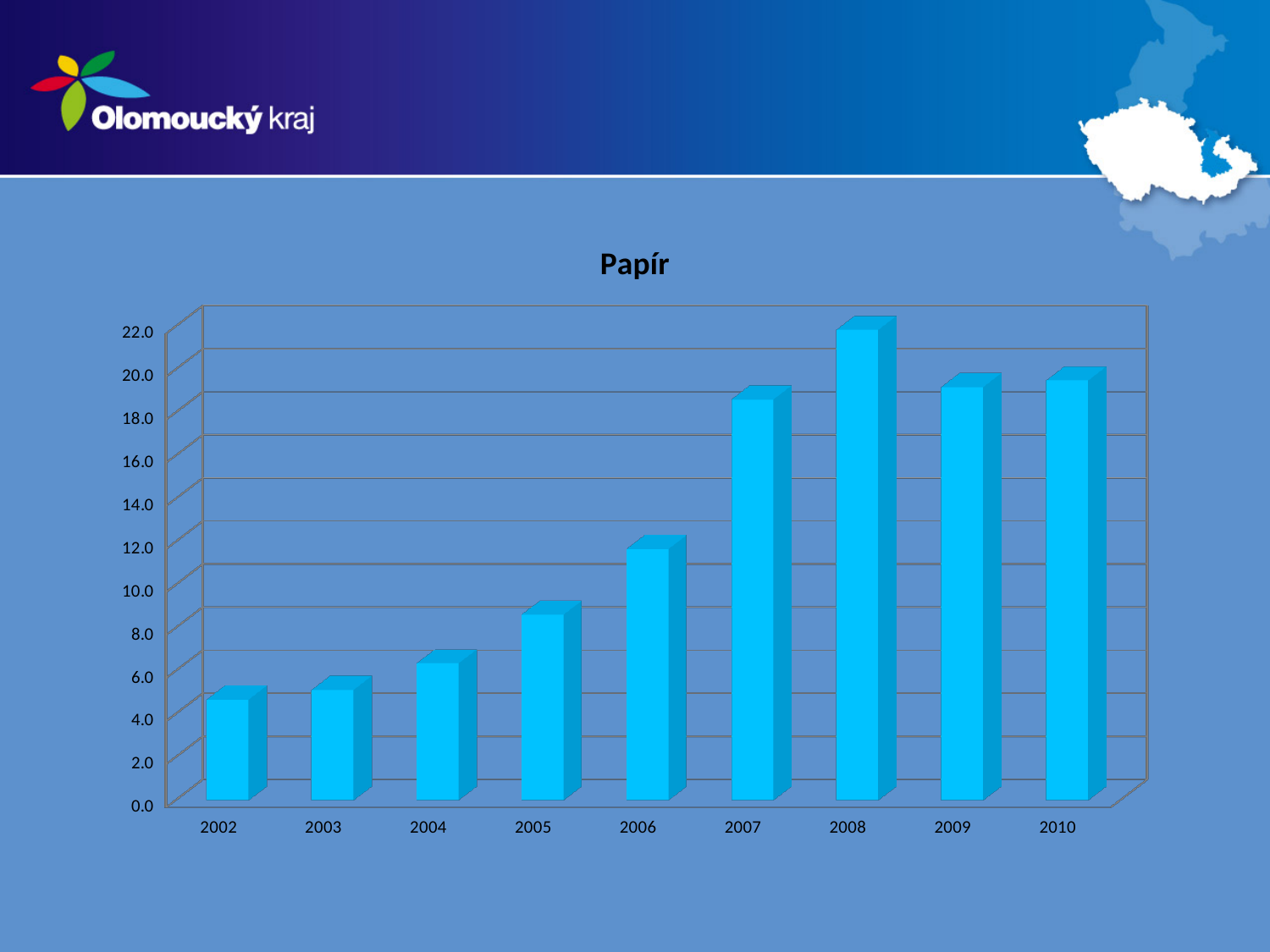
What kind of chart is shown on the slide? bar chart Which year has the lowest value in the chart? 2002 Is the value for 2005 greater or less than 10.0? less Is the value for 2007 greater or less than 16.0? greater What is the title of the chart? Papír Is the value for 2006 greater or less than 10.0? greater How many years are shown on the x axis of the chart? 9 Which year has the larger value, 2007 or 2008? 2008 Which year has the highest value in the chart? 2008 Do the values generally rise or fall from 2002 to 2008? rise